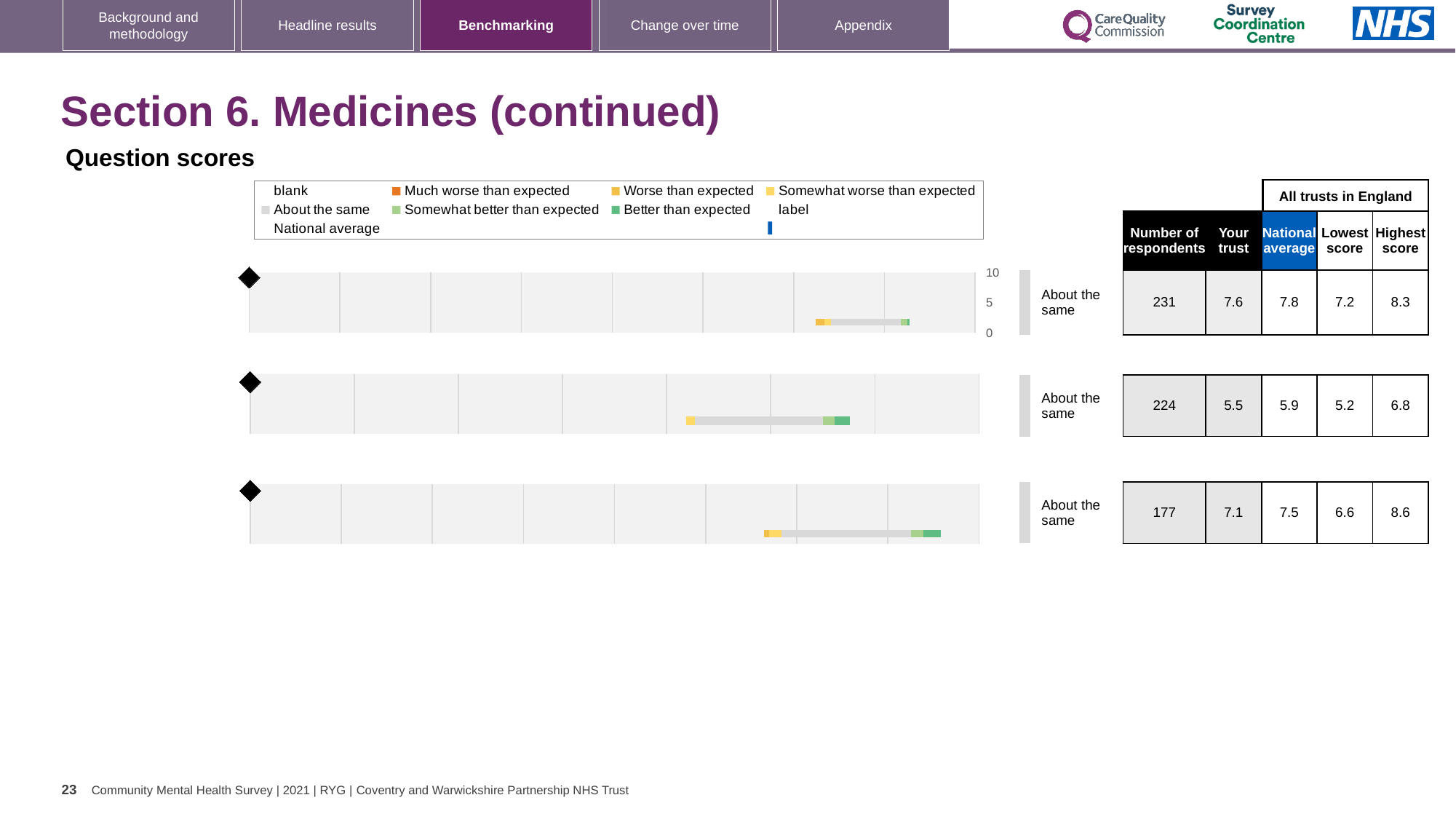
For the middle chart, what is the number of respondents? 224 What kind of chart is used for the benchmarking rows on this slide? bar chart Which of the three charts has the lowest 'Your trust' score? the middle chart How many benchmarking charts are shown on the slide? 3 What benchmark rating is given for the bottom chart? About the same What is the highest value shown on the axis of the top chart? 10 For the bottom chart, which is larger: the 'Your trust' score or the 'National average' score? National average In the legend, which colour represents 'Much worse than expected'? orange For the top chart, what is the 'Your trust' score shown in the table? 7.6 For the bottom chart, what is the 'Highest score' shown in the table? 8.6 For the middle chart, what is the 'National average' score shown in the table? 5.9 For the top chart, what is the difference between the 'National average' and 'Your trust' scores? 0.2